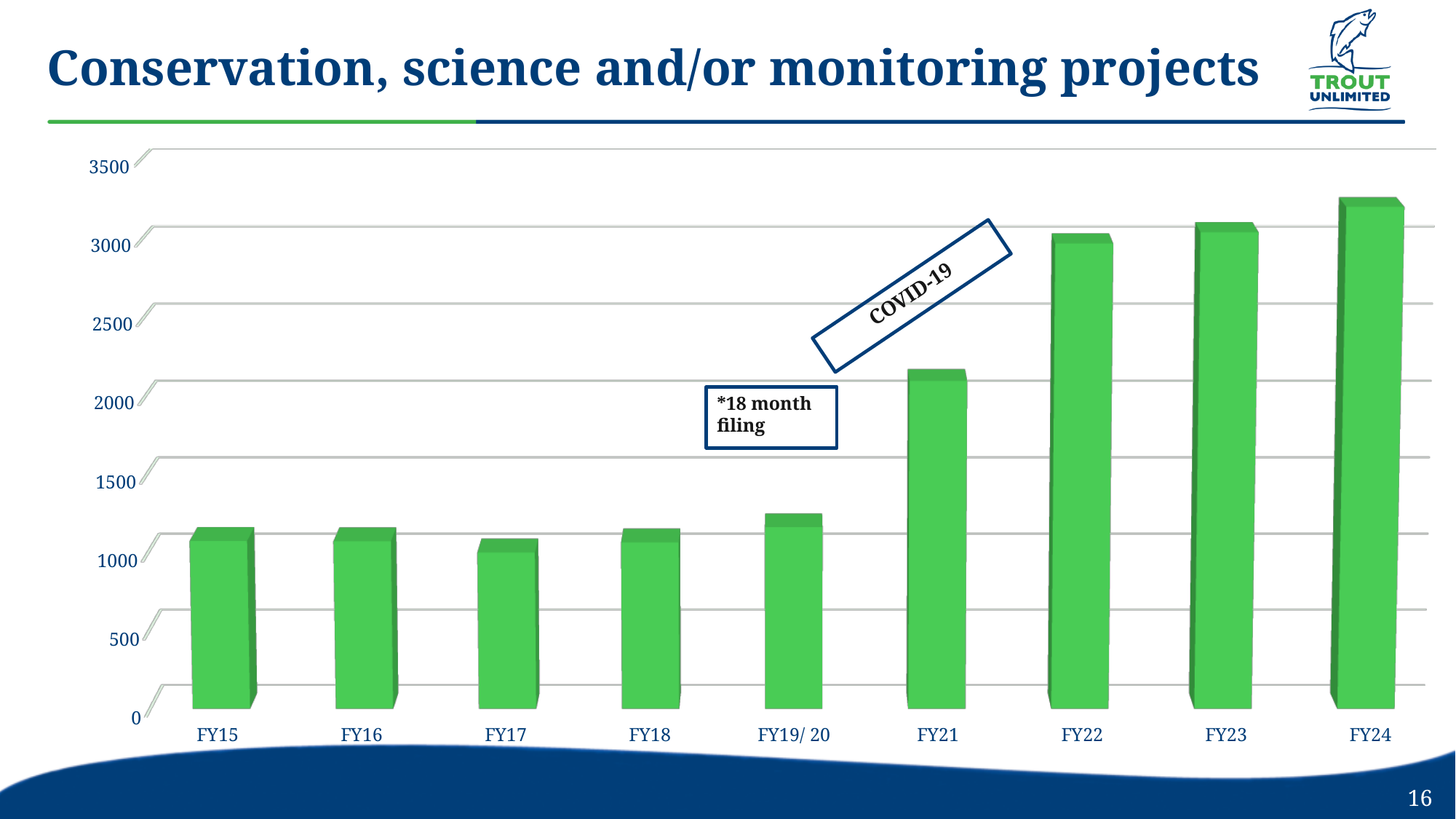
Is the value for FY24 greater or less than 3000? greater Do the values generally rise or fall from FY15 to FY24? Rise Is the value for FY21 greater or less than 2000? greater Which is larger, the value for FY21 or the value for FY18? FY21 Which fiscal year has the lowest number of projects? FY17 What is the title of the slide's chart? Conservation, science and/or monitoring projects Is the value for FY22 greater or less than 2500? greater Which fiscal year has the highest number of projects? FY24 What annotation is placed near the FY21 bar on the chart? COVID-19 How many fiscal-year categories are plotted on the chart? 9 What kind of chart is shown on the slide? Bar chart